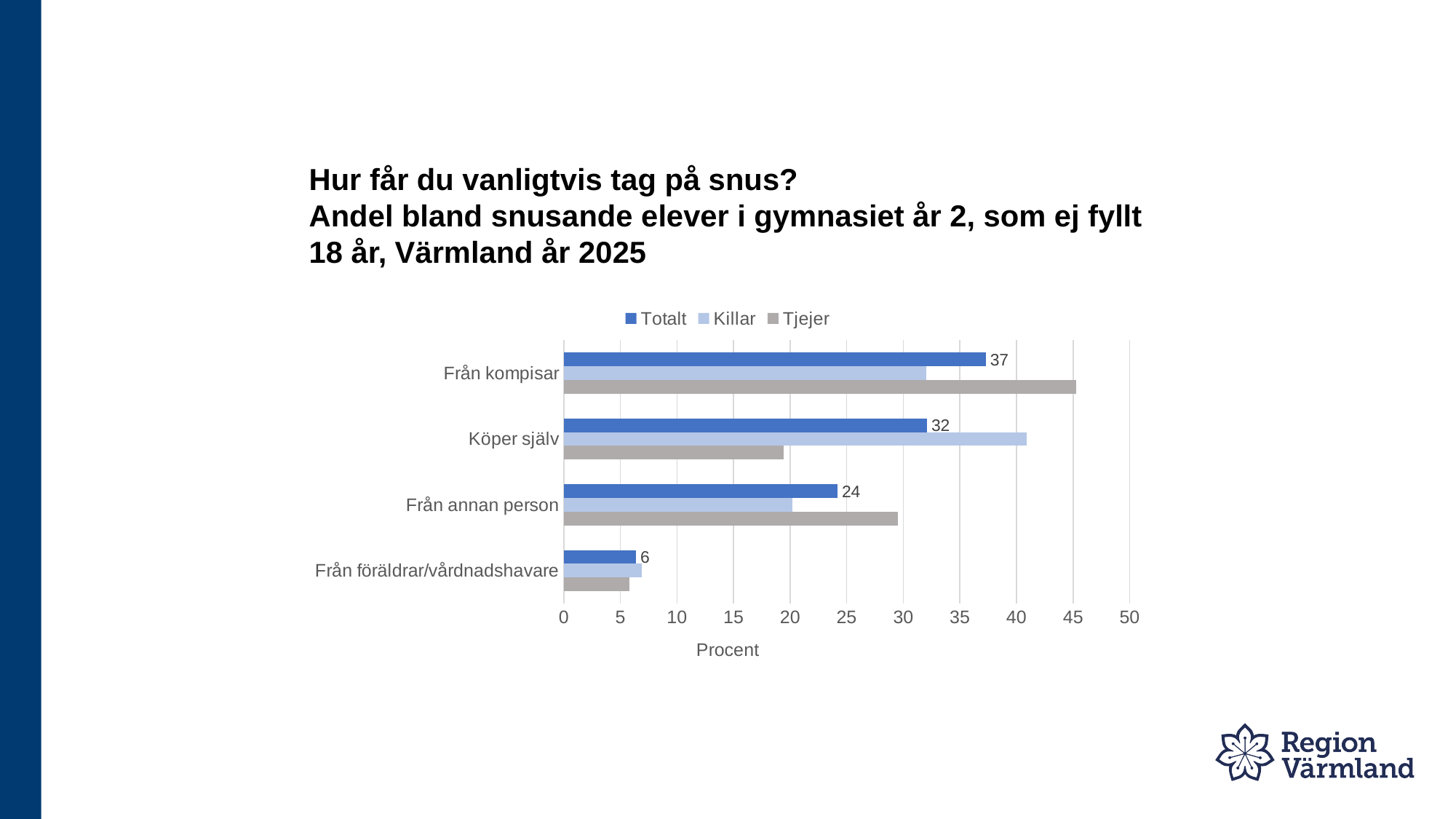
Is the Tjejer value for Från kompisar greater or less than 40? greater For Köper själv, which is larger: the Killar value or the Tjejer value? Killar What kind of chart is shown on the slide? bar chart What is the Totalt value for Från annan person? 24 What is the Totalt value for Från föräldrar/vårdnadshavare? 6 What is the Totalt value for Köper själv? 32 Which category has the highest Totalt value? Från kompisar How many categories are shown on the chart? 4 What is the difference between the Totalt values for Från kompisar and Köper själv? 5 Which category has the lowest Totalt value? Från föräldrar/vårdnadshavare How many series does the legend list? 3 What is the Totalt value for Från kompisar? 37